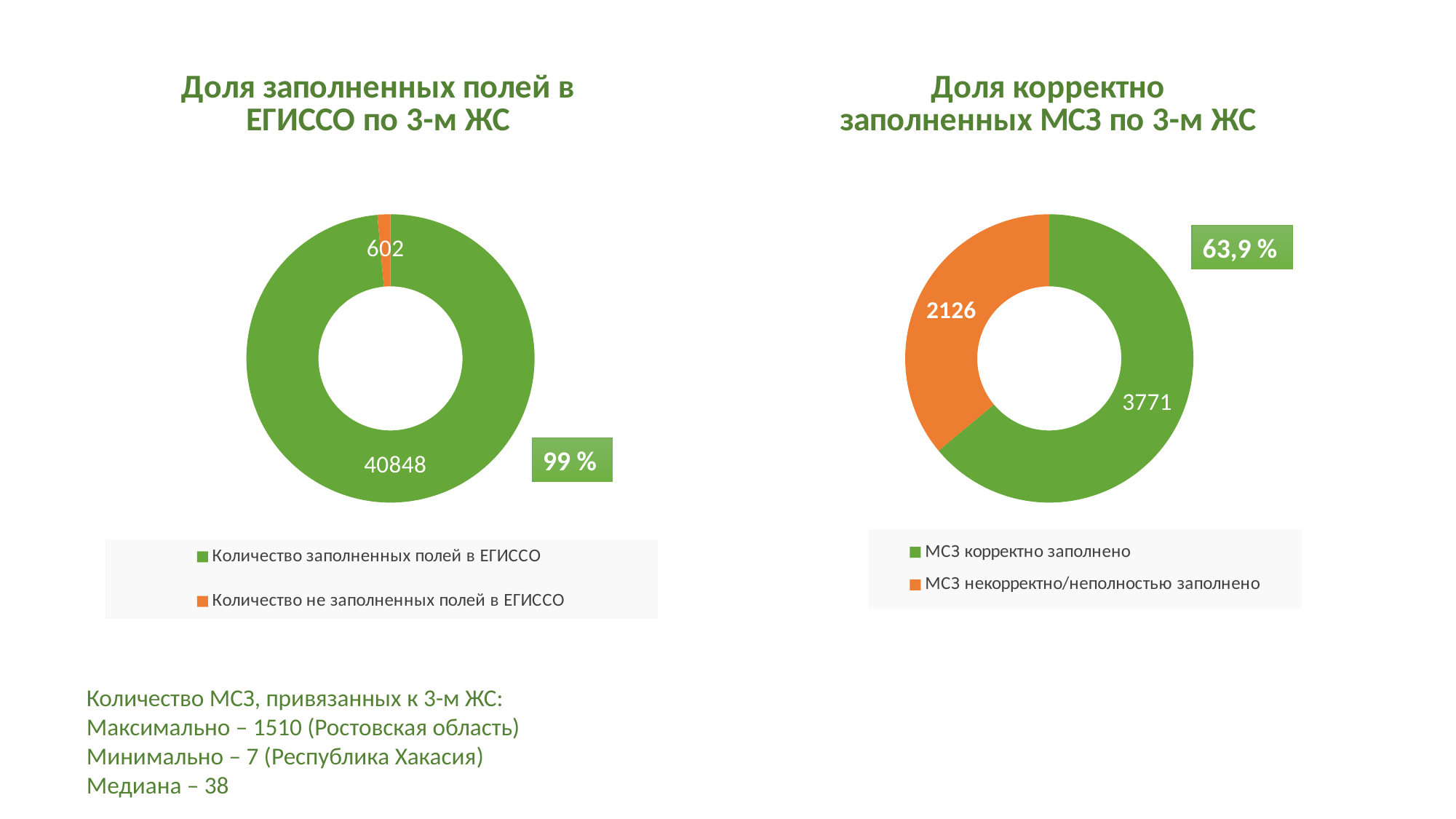
In the right chart 'Доля корректно заполненных МСЗ по 3-м ЖС', what is the difference between 'МСЗ корректно заполнено' and 'МСЗ некорректно/неполностью заполнено'? 1645 In the left chart 'Доля заполненных полей в ЕГИССО по 3-м ЖС', which category is the smallest? Количество не заполненных полей в ЕГИССО How many entries does the legend of the left chart 'Доля заполненных полей в ЕГИССО по 3-м ЖС' list? 2 In the left chart 'Доля заполненных полей в ЕГИССО по 3-м ЖС', what share of the pie is labelled for the filled fields? 99 % In the left chart 'Доля заполненных полей в ЕГИССО по 3-м ЖС', what is the total of the two values shown? 41450 In the right chart 'Доля корректно заполненных МСЗ по 3-м ЖС', what is the value for 'МСЗ некорректно/неполностью заполнено'? 2126 In the right chart 'Доля корректно заполненных МСЗ по 3-м ЖС', what share is labelled for correctly filled МСЗ? 63,9 % In the right chart 'Доля корректно заполненных МСЗ по 3-м ЖС', which category is larger: 'МСЗ корректно заполнено' or 'МСЗ некорректно/неполностью заполнено'? МСЗ корректно заполнено What kind of chart is the right chart 'Доля корректно заполненных МСЗ по 3-м ЖС'? Donut (pie) chart In the left chart 'Доля заполненных полей в ЕГИССО по 3-м ЖС', what is the value for 'Количество не заполненных полей в ЕГИССО'? 602 In the left chart 'Доля заполненных полей в ЕГИССО по 3-м ЖС', what is the value for 'Количество заполненных полей в ЕГИССО'? 40848 In the right chart 'Доля корректно заполненных МСЗ по 3-м ЖС', what is the value for 'МСЗ корректно заполнено'? 3771